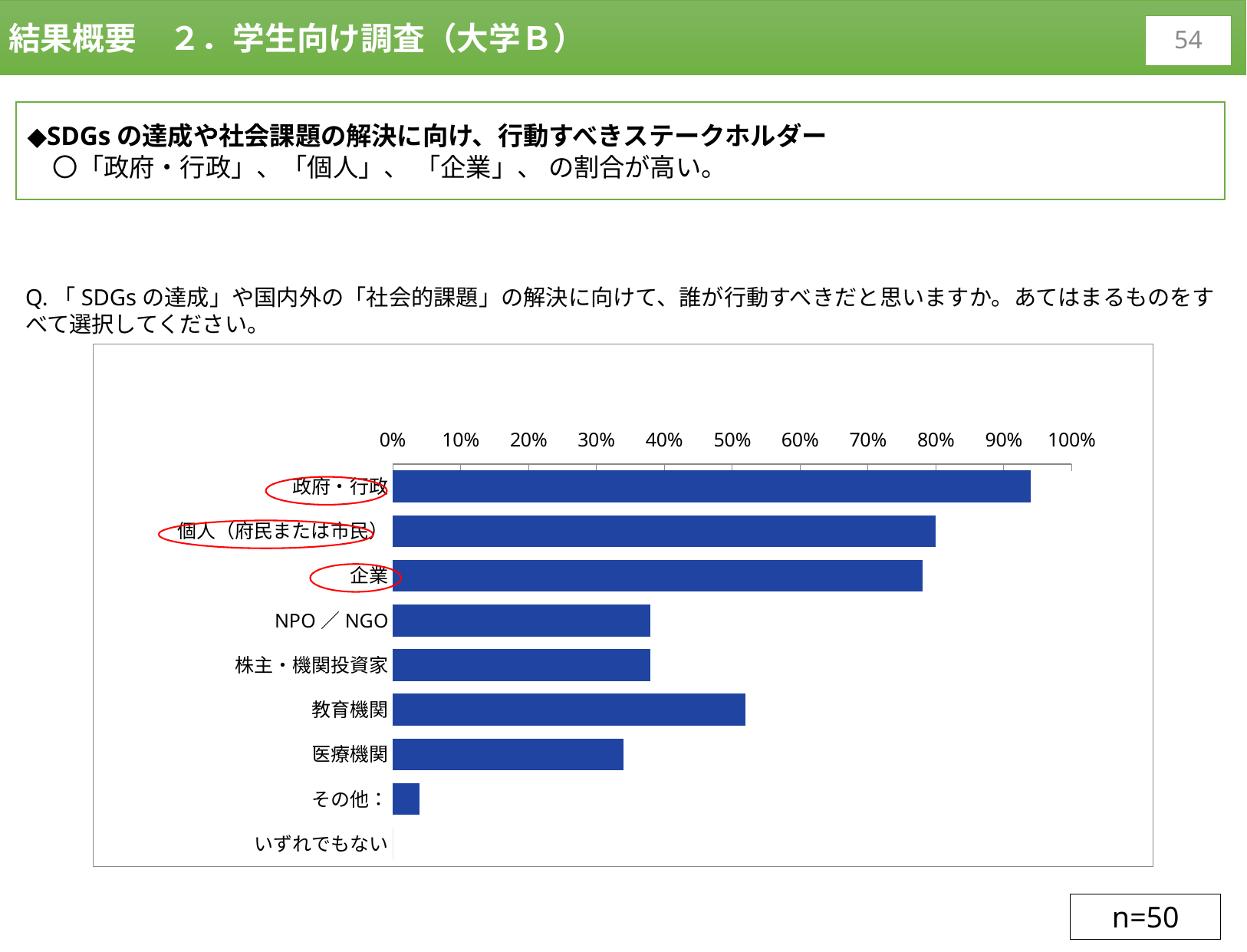
Which has the larger value, 教育機関 or 医療機関? 教育機関 Is the value for 政府・行政 greater or less than 90%? greater What sample size (n) is shown on the slide for this chart? n=50 Is the value for 教育機関 greater or less than 40%? greater What kind of chart is shown on the slide? bar chart Is the value for その他： greater or less than 10%? less Which has the larger value, 政府・行政 or 企業? 政府・行政 How many categories are listed on the chart's vertical axis? 9 Which category has the lowest value in the chart? いずれでもない Which category has the highest value in the chart? 政府・行政